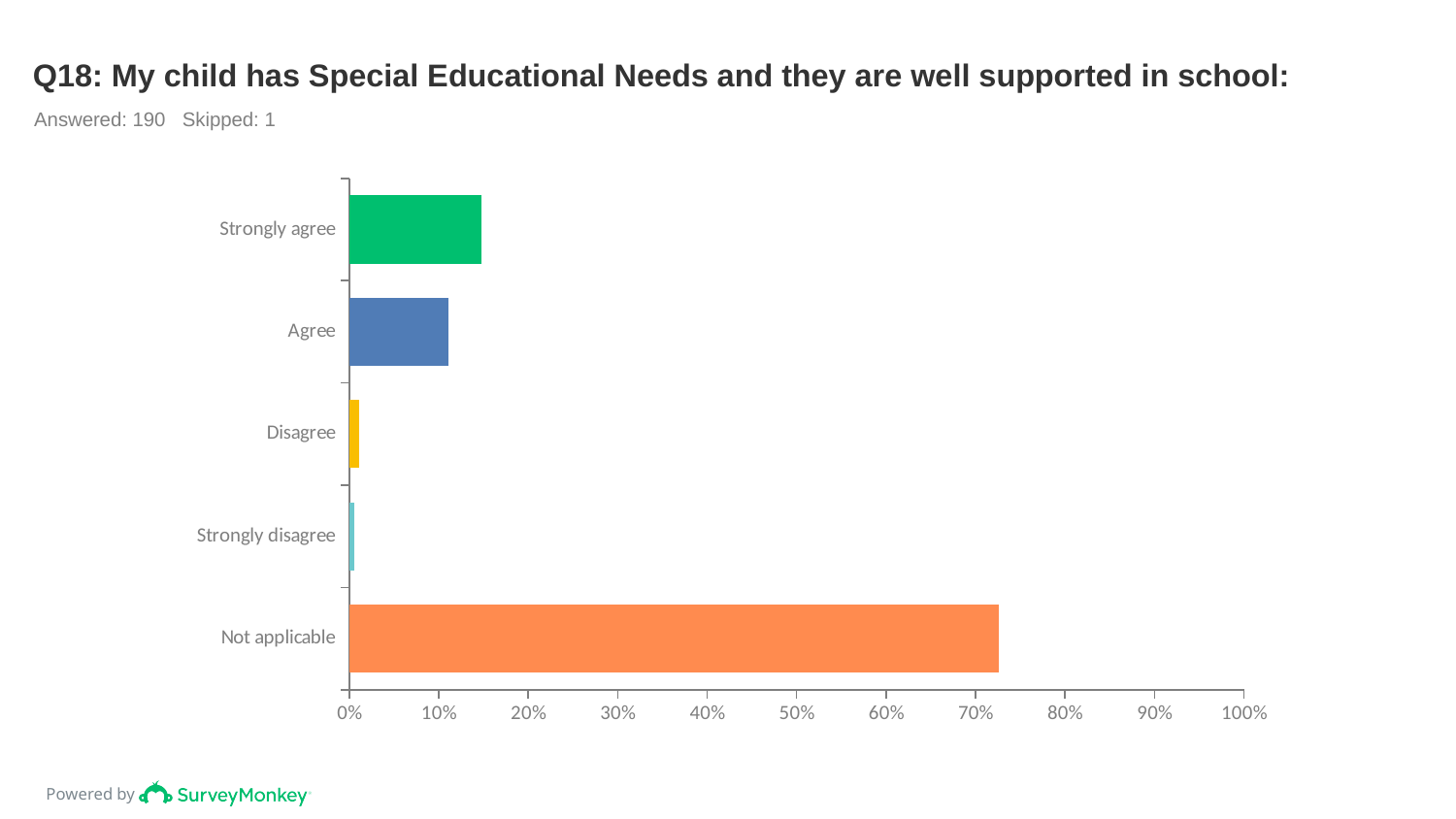
Which is larger, the value for Disagree or the value for Not applicable? Not applicable Is the value for Strongly agree greater or less than 10%? greater What is the title of the chart? Q18: My child has Special Educational Needs and they are well supported in school: Which category has the lowest value? Strongly disagree Which is larger, the value for Strongly agree or the value for Agree? Strongly agree Is the value for Strongly agree greater or less than 20%? less Is the value for Disagree greater or less than 10%? less How many categories are plotted on the chart? 5 What kind of chart is shown on the slide? bar chart Which category has the highest value? Not applicable